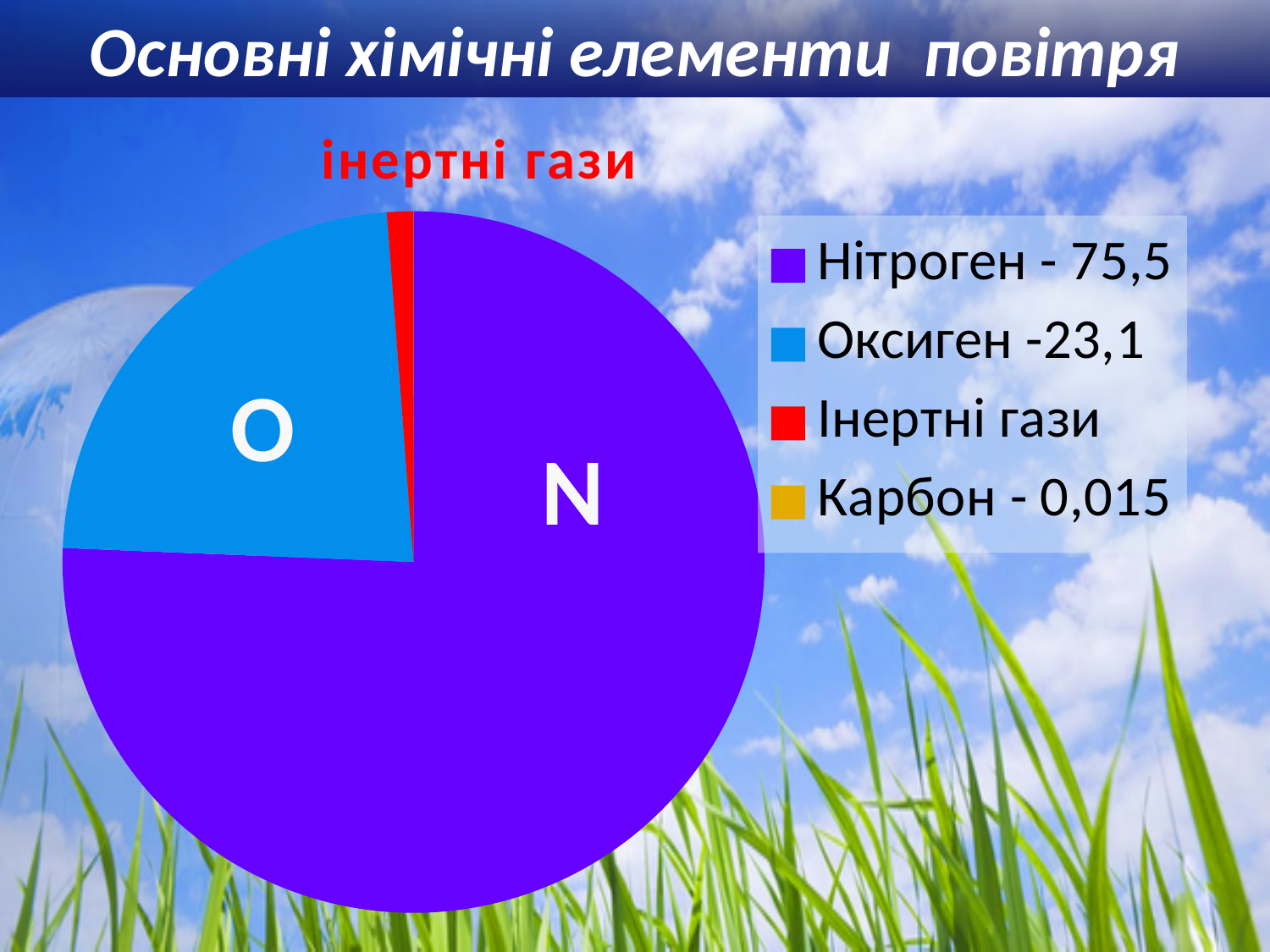
Which is larger, the value for Оксиген or the value for Карбон? Оксиген What is the value shown in the legend for Нітроген? 75,5 What is the difference between the values for Нітроген and Оксиген? 52,4 How many entries does the legend list? 4 Which legend entry has the smallest value? Карбон What is the title of the chart? Основні хімічні елементи повітря What is the value shown in the legend for Карбон? 0,015 What colour is the slice for Оксиген? blue What is the value shown in the legend for Оксиген? 23,1 What kind of chart is shown on the slide? pie chart Which category has the largest slice of the pie? Нітроген